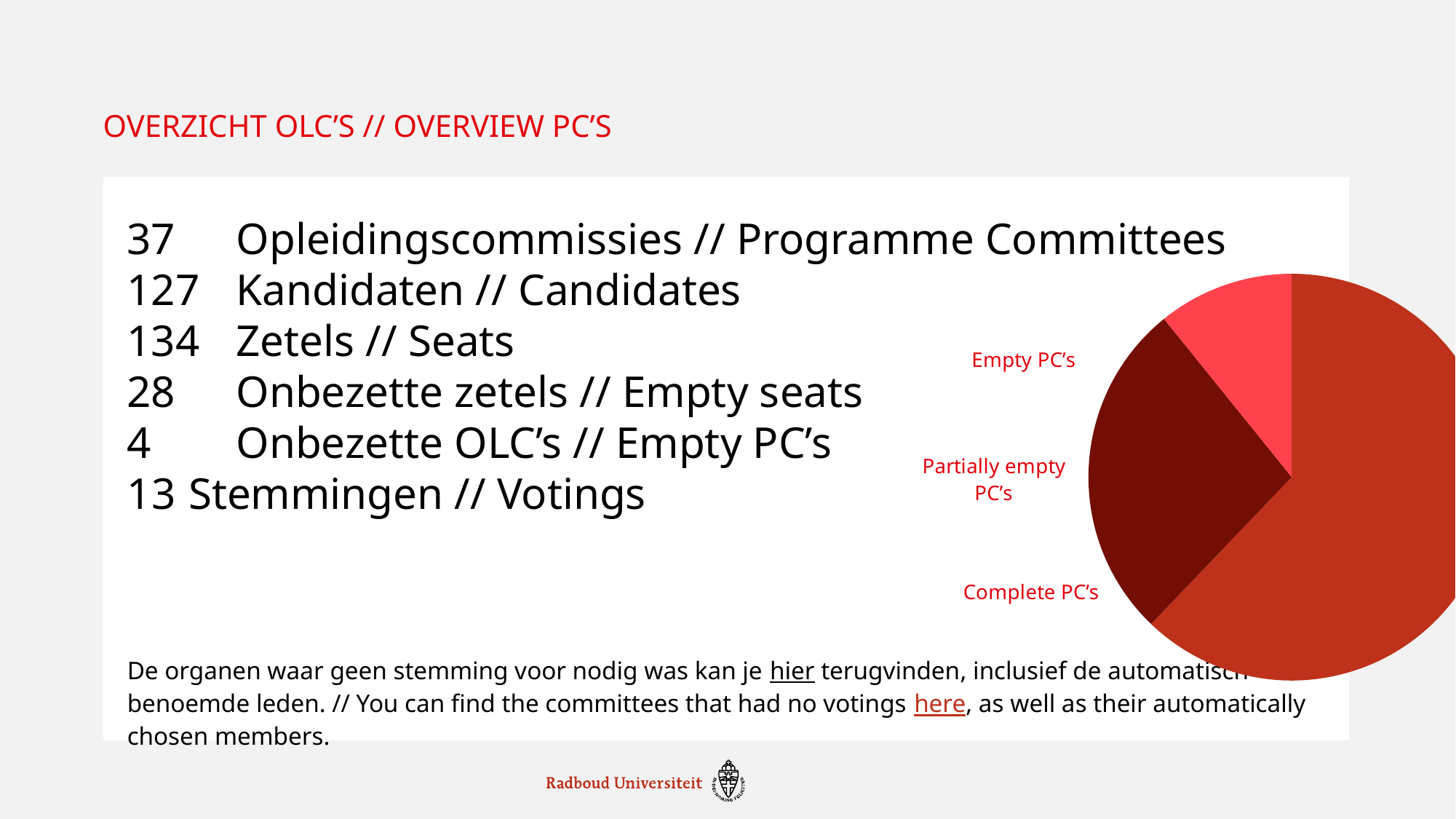
Which slice of the pie chart is the largest? Complete PC's Which slice is larger in the pie chart: Partially empty PC's or Empty PC's? Partially empty PC's Which slice of the pie chart is drawn in the darkest red? Partially empty PC's How many slices does the pie chart have? 3 Which slice is larger in the pie chart: Complete PC's or Partially empty PC's? Complete PC's Which slice of the pie chart is the smallest? Empty PC's What kind of chart is shown on the slide? pie chart What are the three categories labelled on the pie chart? Empty PC's, Partially empty PC's, Complete PC's Does the Complete PC's slice take up more or less than half of the pie chart? more